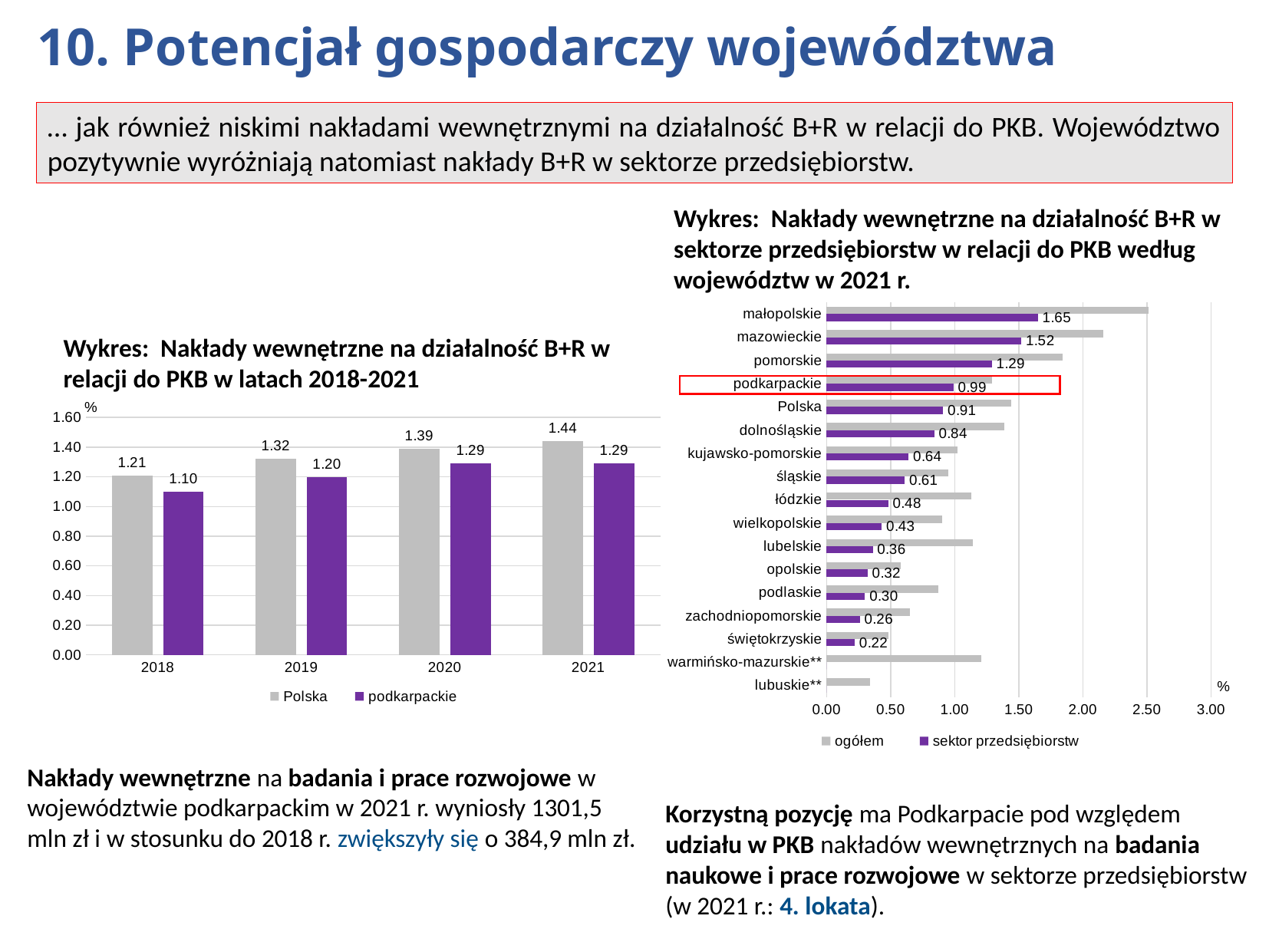
In the right chart (Nakłady wewnętrzne na działalność B+R w sektorze przedsiębiorstw w relacji do PKB według województw w 2021 r.), is the ogółem value for mazowieckie greater or less than 2.00? greater In the left chart (Nakłady wewnętrzne na działalność B+R w relacji do PKB w latach 2018-2021), how many series does the legend list? 2 In the right chart (Nakłady wewnętrzne na działalność B+R w sektorze przedsiębiorstw w relacji do PKB według województw w 2021 r.), which is larger: the sektor przedsiębiorstw value for Polska or for dolnośląskie? Polska In the right chart (Nakłady wewnętrzne na działalność B+R w sektorze przedsiębiorstw w relacji do PKB według województw w 2021 r.), what is the sektor przedsiębiorstw value for podkarpackie? 0.99 In the right chart (Nakłady wewnętrzne na działalność B+R w sektorze przedsiębiorstw w relacji do PKB według województw w 2021 r.), what is the difference between the sektor przedsiębiorstw values for mazowieckie and pomorskie? 0.23 What kind of chart is the left chart (Nakłady wewnętrzne na działalność B+R w relacji do PKB w latach 2018-2021)? bar chart In the left chart (Nakłady wewnętrzne na działalność B+R w relacji do PKB w latach 2018-2021), do the values for Polska rise or fall from 2018 to 2021? rise In the left chart (Nakłady wewnętrzne na działalność B+R w relacji do PKB w latach 2018-2021), what is the value for podkarpackie in 2018? 1.10 In the left chart (Nakłady wewnętrzne na działalność B+R w relacji do PKB w latach 2018-2021), what is the difference between Polska and podkarpackie in 2021? 0.15 In the left chart (Nakłady wewnętrzne na działalność B+R w relacji do PKB w latach 2018-2021), what is the value for Polska in 2021? 1.44 In the right chart (Nakłady wewnętrzne na działalność B+R w sektorze przedsiębiorstw w relacji do PKB według województw w 2021 r.), which voivodeship has the highest sektor przedsiębiorstw value? małopolskie In the right chart (Nakłady wewnętrzne na działalność B+R w sektorze przedsiębiorstw w relacji do PKB według województw w 2021 r.), which labelled category has the lowest sektor przedsiębiorstw value? świętokrzyskie